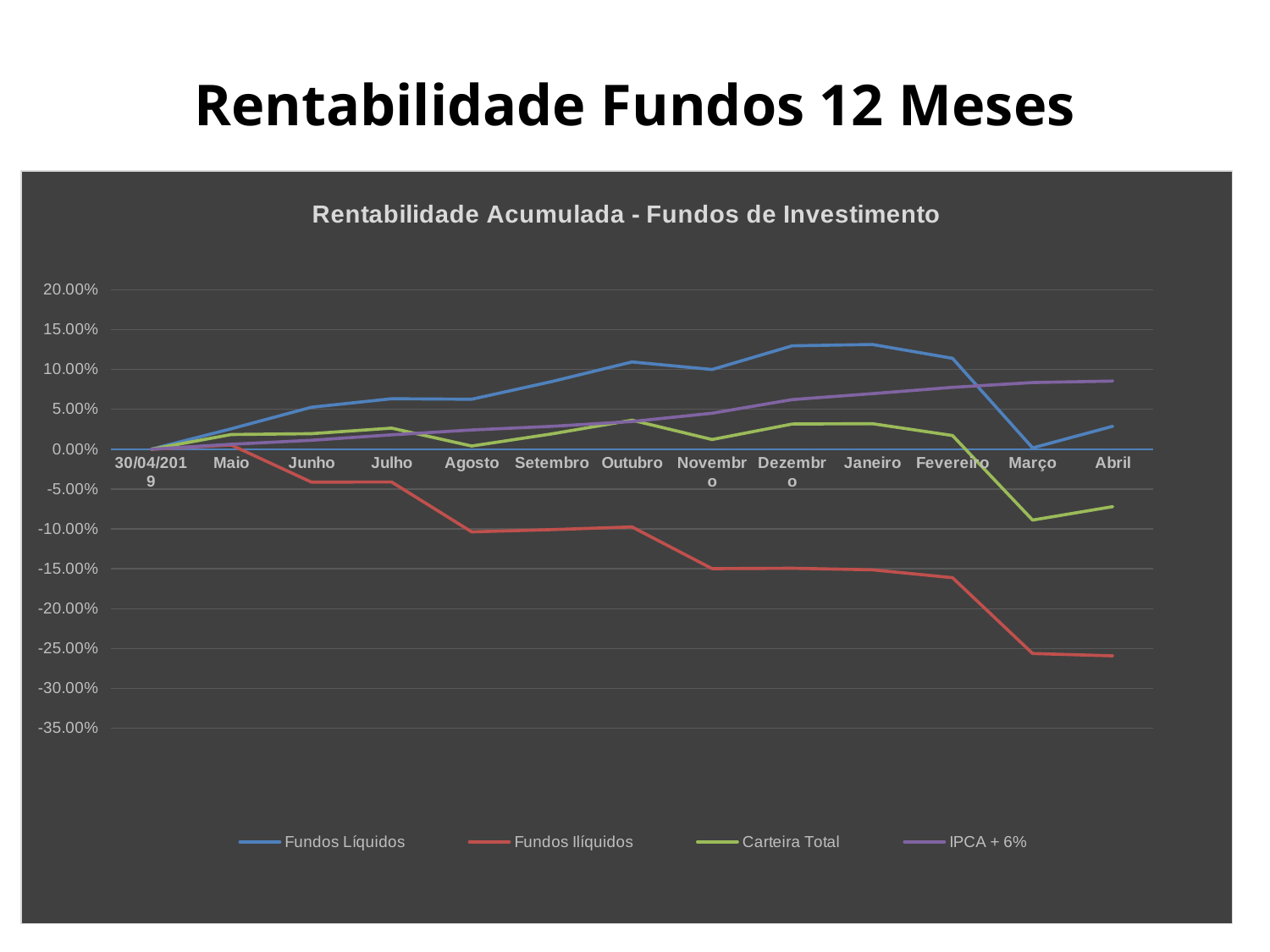
Which series is drawn in red in the legend? Fundos Ilíquidos How many series does the legend list? 4 Is the value for Carteira Total in Março greater or less than -5.00%? less Is the value for Fundos Líquidos in Janeiro greater or less than 10.00%? greater Is the value for IPCA + 6% in Abril greater or less than 5.00%? greater In Janeiro, which is larger: Fundos Líquidos or Fundos Ilíquidos? Fundos Líquidos What kind of chart is shown on the slide? Line chart How many points are plotted along the x axis for each series? 13 Does the IPCA + 6% series rise or fall from 30/04/2019 to Abril? Rise Which series has the lowest value in Abril? Fundos Ilíquidos What is the title of the chart? Rentabilidade Acumulada - Fundos de Investimento